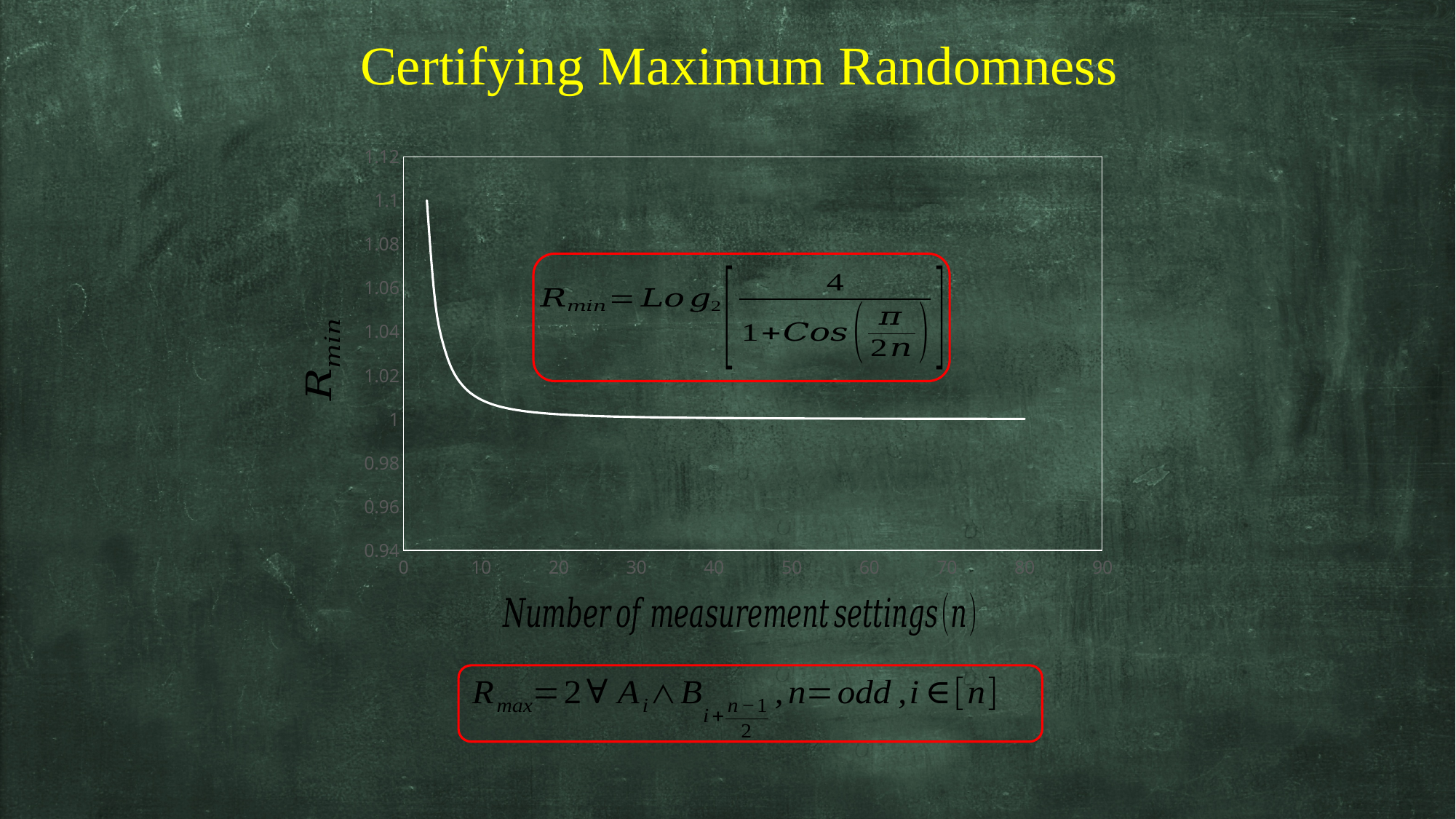
Is the value of R_min at n = 20 greater or less than 0.98? greater What is the label of the x axis of the chart? Number of measurement settings (n) What is the highest value shown on the y axis of the chart? 1.12 How many lines are plotted on the chart? 1 Is R_min higher at the smallest n or at the largest n plotted? smallest n What kind of chart is shown on the slide? line chart Is the value of R_min at n = 40 greater or less than 1.04? less Is the value of R_min at the right end of the curve (around n = 80) greater or less than 1.02? less What is the label of the y axis of the chart? R_min Does R_min rise or fall as the number of measurement settings (n) increases? fall